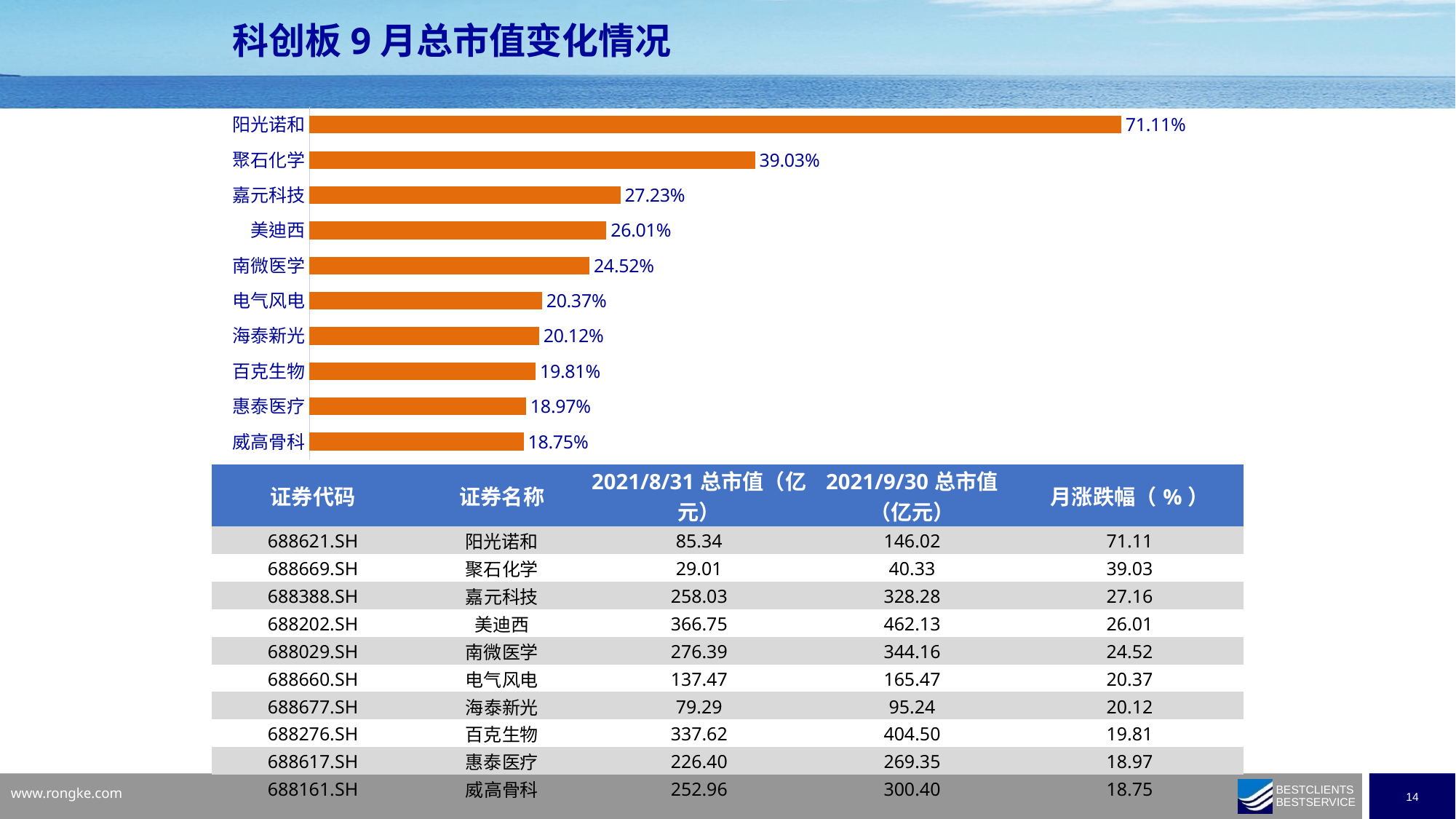
What is the value shown for 聚石化学 in the bar chart? 39.03% What is the value shown for 阳光诺和 in the bar chart? 71.11% Which category has the lowest value in the bar chart? 威高骨科 What is the value shown for 海泰新光 in the bar chart? 20.12% Which category has the highest value in the bar chart? 阳光诺和 Which is larger in the bar chart, the value for 嘉元科技 or the value for 电气风电? 嘉元科技 What is the difference between the values for 美迪西 and 南微医学 in the bar chart? 1.49% What kind of chart is shown on the slide? Bar chart How many categories are shown in the bar chart? 10 What colour are the bars in the chart? Orange What is the difference between the values for 阳光诺和 and 聚石化学 in the bar chart? 32.08% What is the value shown for 威高骨科 in the bar chart? 18.75%